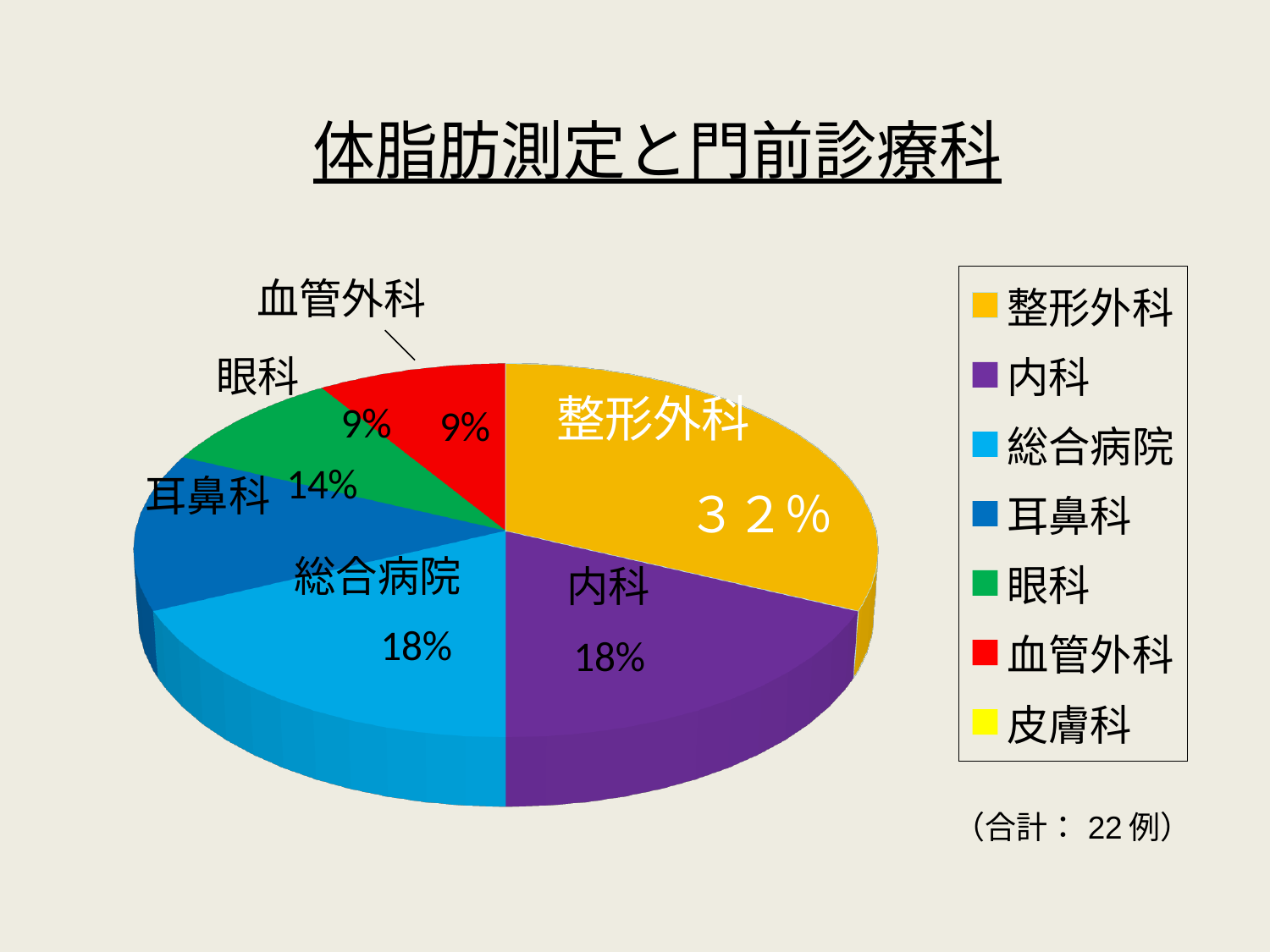
What kind of chart is shown on the slide? pie chart What total number of cases is noted below the legend? 22例 What percentage of the pie does 整形外科 account for? 32% What percentage is shown for 耳鼻科? 14% What percentage is shown for 血管外科? 9% Which category has the largest share of the pie? 整形外科 What percentage is shown for 内科? 18% What percentage is shown for 眼科? 9% What is the difference in percentage points between 整形外科 and 内科? 14% Which has the larger share, 耳鼻科 or 眼科? 耳鼻科 What is the title of the chart? 体脂肪測定と門前診療科 How many categories are listed in the legend? 7